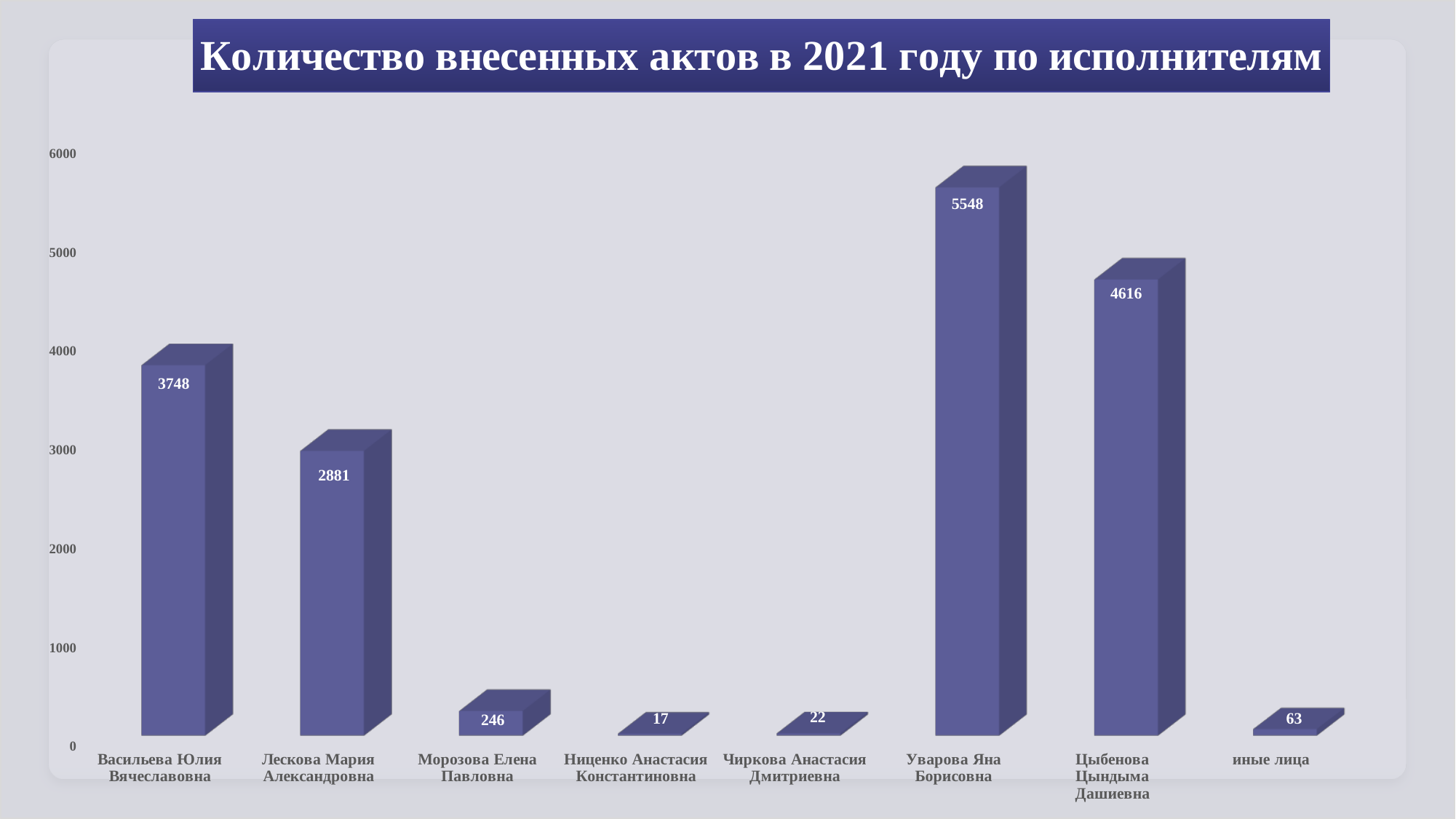
How many categories are shown on the x axis? 8 Which category has the lowest value? Ниценко Анастасия Константиновна What kind of chart is shown on the slide? bar chart Is the value for Цыбенова Цындыма Дашиевна greater or less than 4000? greater What is the value for Васильева Юлия Вячеславовна? 3748 What is the title of the chart? Количество внесенных актов в 2021 году по исполнителям Which is larger, the value for Лескова Мария Александровна or the value for Васильева Юлия Вячеславовна? Васильева Юлия Вячеславовна What is the difference between the values for Уварова Яна Борисовна and Цыбенова Цындыма Дашиевна? 932 What is the value for Морозова Елена Павловна? 246 What is the value for Уварова Яна Борисовна? 5548 What is the value for иные лица? 63 Which category has the highest value? Уварова Яна Борисовна